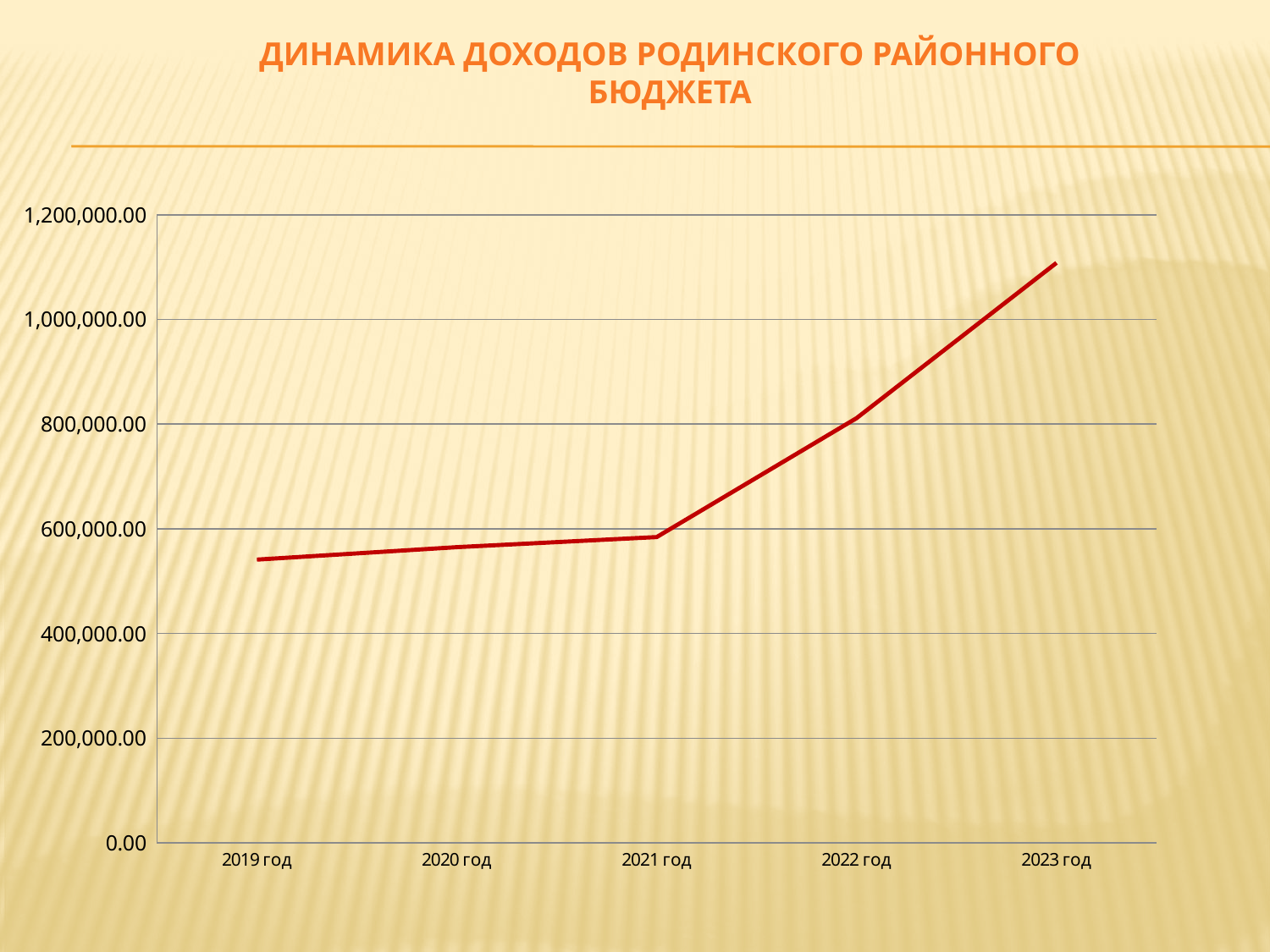
Is the value for 2023 год greater or less than 1,000,000.00? greater What is the title of the chart on the slide? ДИНАМИКА ДОХОДОВ РОДИНСКОГО РАЙОННОГО БЮДЖЕТА How many years are plotted along the x axis? 5 Is the value for 2021 год greater or less than 400,000.00? greater Is the value for 2019 год greater or less than 600,000.00? less Which year has the highest value on the chart? 2023 год What colour is the line on the chart? red Do the values rise or fall from 2019 год to 2023 год? rise Which is larger, the value for 2022 год or the value for 2021 год? 2022 год What kind of chart is shown on the slide? line chart Which year has the lowest value on the chart? 2019 год